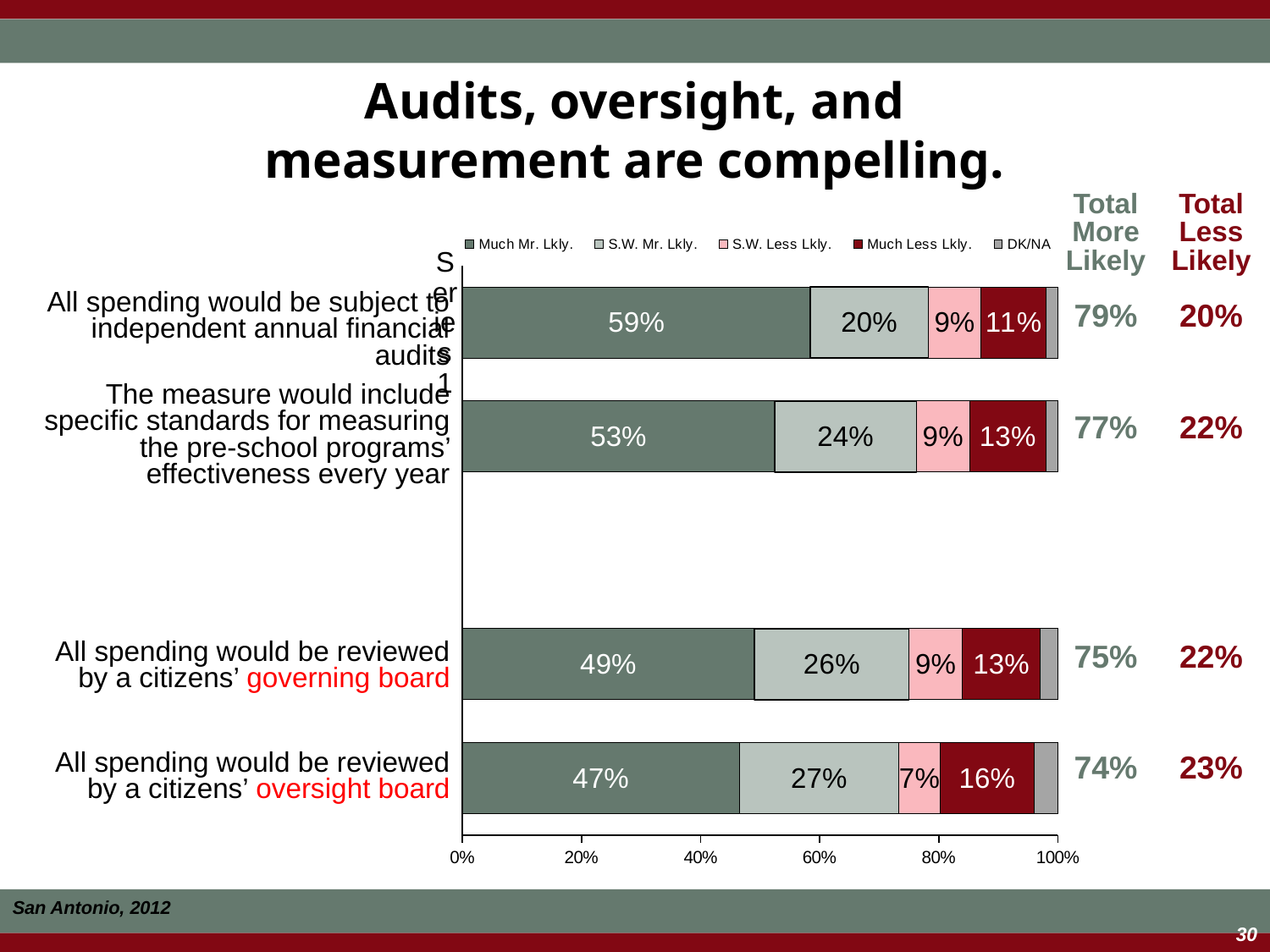
Is the 'Much Mr. Lkly.' value for the citizens' oversight board statement greater or less than 40%? greater What is the difference between the 'Much Mr. Lkly.' values for the independent annual financial audits statement and the citizens' governing board statement? 10% What is the 'Much Mr. Lkly.' value for 'All spending would be subject to independent annual financial audits'? 59% Which is larger: the 'Much Less Lkly.' value for the citizens' oversight board statement or for the citizens' governing board statement? Citizens' oversight board (16%) How many series does the chart legend list? 5 How many statements (categories) are plotted in the chart? 4 Which statement has the lowest 'Much Mr. Lkly.' value? All spending would be reviewed by a citizens' oversight board What is the 'Much Less Lkly.' value for 'The measure would include specific standards for measuring the pre-school programs' effectiveness every year'? 13% What kind of chart is shown on the slide? Stacked bar chart What is the 'Total More Likely' figure shown for 'All spending would be reviewed by a citizens' governing board'? 75% What is the 'S.W. Mr. Lkly.' value for 'All spending would be reviewed by a citizens' oversight board'? 27% Which statement has the highest 'Much Mr. Lkly.' value? All spending would be subject to independent annual financial audits